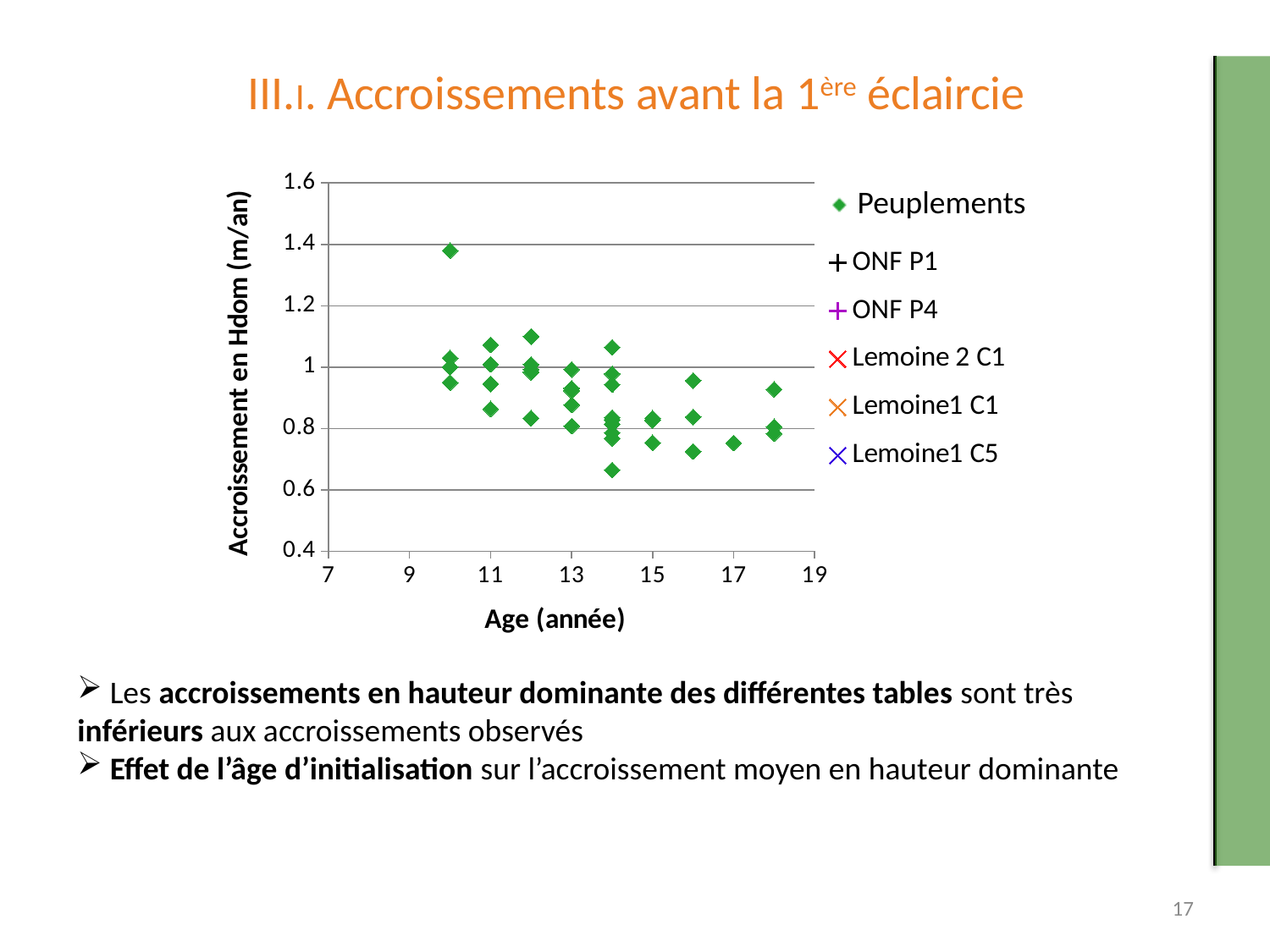
Do the Peuplements values generally rise or fall as age increases? fall What is the title of the x axis of the chart? Age (année) How many series does the chart legend list? 6 What kind of chart is shown on the slide? scatter chart Is the highest Peuplements value at age 10 greater or less than 1.2? greater Is the lowest Peuplements value at age 14 greater or less than 0.8? less Is the highest Peuplements value at age 10 larger or smaller than the highest value at age 16? larger What is the title of the y axis of the chart? Accroissement en Hdom (m/an) Is the Peuplements value at age 17 greater or less than 0.8? less At which age does the highest Peuplements value occur? 10 At which age does the lowest Peuplements value occur? 14